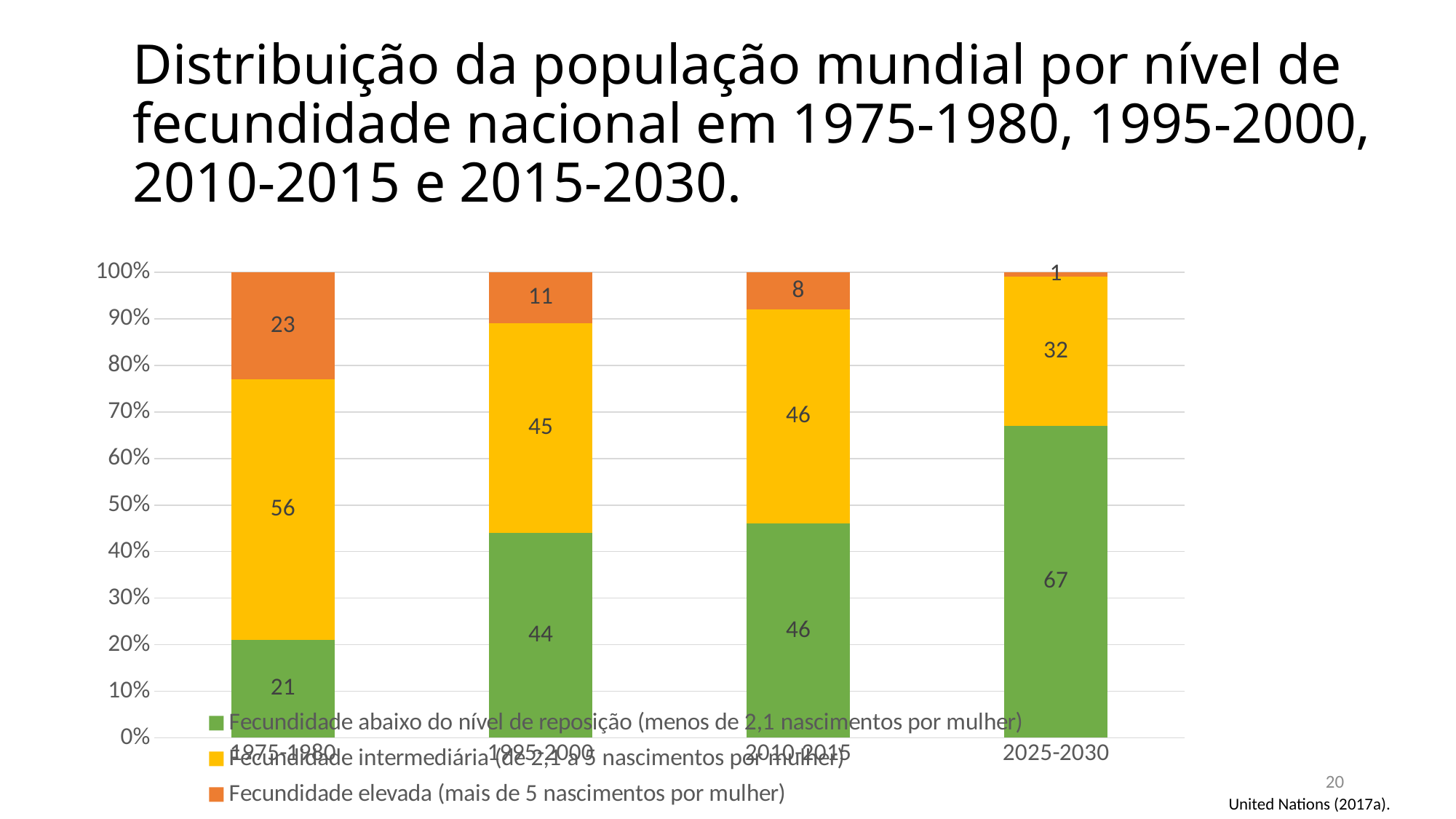
Which is larger for 2025-2030: the 'Fecundidade abaixo do nível de reposição' segment or the 'Fecundidade intermediária' segment? Fecundidade abaixo do nível de reposição What is the value of the 'Fecundidade abaixo do nível de reposição' segment for 2025-2030? 67 What is the value of the 'Fecundidade intermediária' segment for the first bar (1975-1980)? 56 How many series does the legend list? 3 What is the total of the three segments in the 1975-1980 bar? 100 In which period is the 'Fecundidade elevada' segment the smallest? 2025-2030 What kind of chart is shown on the slide? Stacked bar chart What is the value of the 'Fecundidade elevada' segment for 2010-2015? 8 How many period categories are plotted along the x axis? 4 Does the 'Fecundidade abaixo do nível de reposição' segment rise or fall from the first period to the last? Rise In which period is the 'Fecundidade abaixo do nível de reposição' segment the largest? 2025-2030 What is the difference between the 'Fecundidade elevada' values for 1975-1980 and 2025-2030? 22